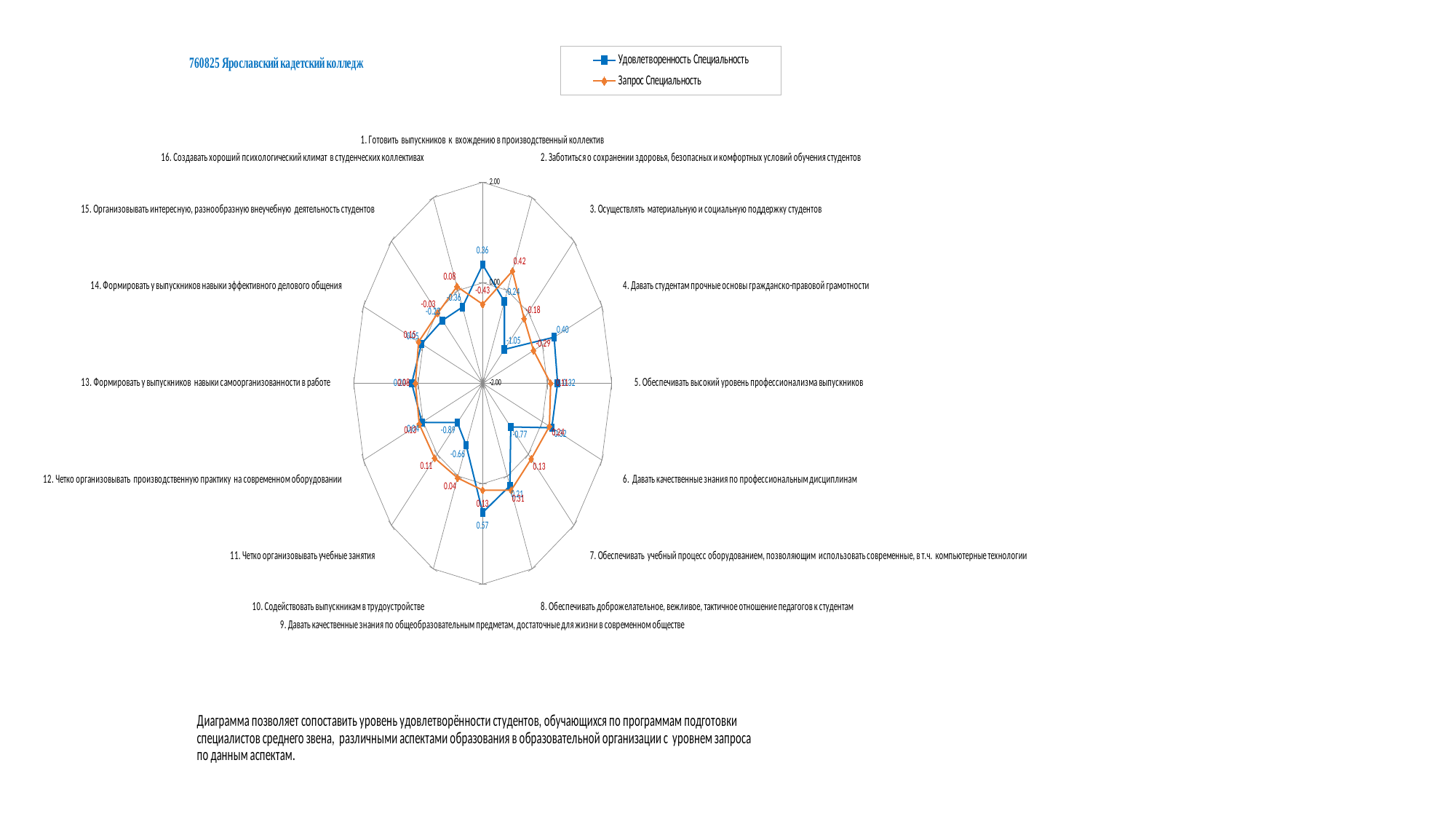
What is the value of Запрос Специальность for category 2 (Заботиться о сохранении здоровья, безопасных и комфортных условий обучения студентов)? 0.42 What is the value of Удовлетворенность Специальность for category 10 (Содействовать выпускникам в трудоустройстве)? -0.66 What is the value of Удовлетворенность Специальность for category 1 (Готовить выпускников к вхождению в производственный коллектив)? 0.36 What are the two series named in the legend? Удовлетворенность Специальность; Запрос Специальность What is the value of Удовлетворенность Специальность for category 3 (Осуществлять материальную и социальную поддержку студентов)? -1.05 What is the value of Запрос Специальность for category 1 (Готовить выпускников к вхождению в производственный коллектив)? -0.43 How many categories (axes) does the radar chart have? 16 How many series does the legend list? 2 What kind of chart is shown on the slide? Radar chart What is the title shown above the chart? 760825 Ярославский кадетский колледж For category 1, which series has the larger value: Удовлетворенность Специальность or Запрос Специальность? Удовлетворенность Специальность